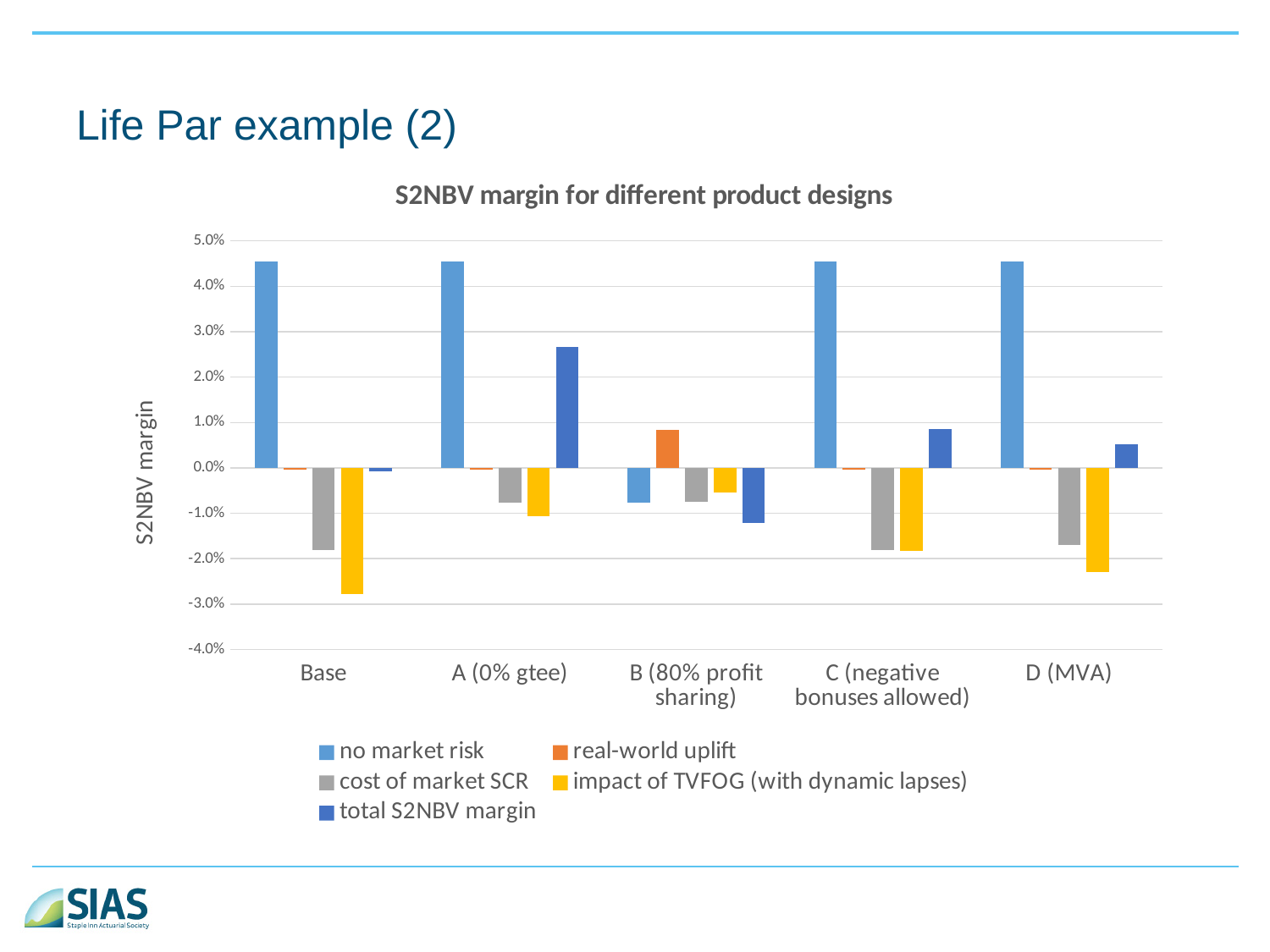
Which product design has the highest total S2NBV margin? A (0% gtee) Is the real-world uplift for B (80% profit sharing) greater or less than 1.0%? less Is the no market risk value for D (MVA) greater or less than 4.0%? greater How many series does the legend list? 5 Which product design has the lowest (most negative) impact of TVFOG (with dynamic lapses)? Base Which product design has the lowest total S2NBV margin? B (80% profit sharing) How many product designs are shown along the x axis? 5 What is the title of the chart? S2NBV margin for different product designs Is the impact of TVFOG (with dynamic lapses) for Base greater or less than -2.0%? less Which has the larger total S2NBV margin, C (negative bonuses allowed) or D (MVA)? C (negative bonuses allowed) What kind of chart is shown on the slide? bar chart